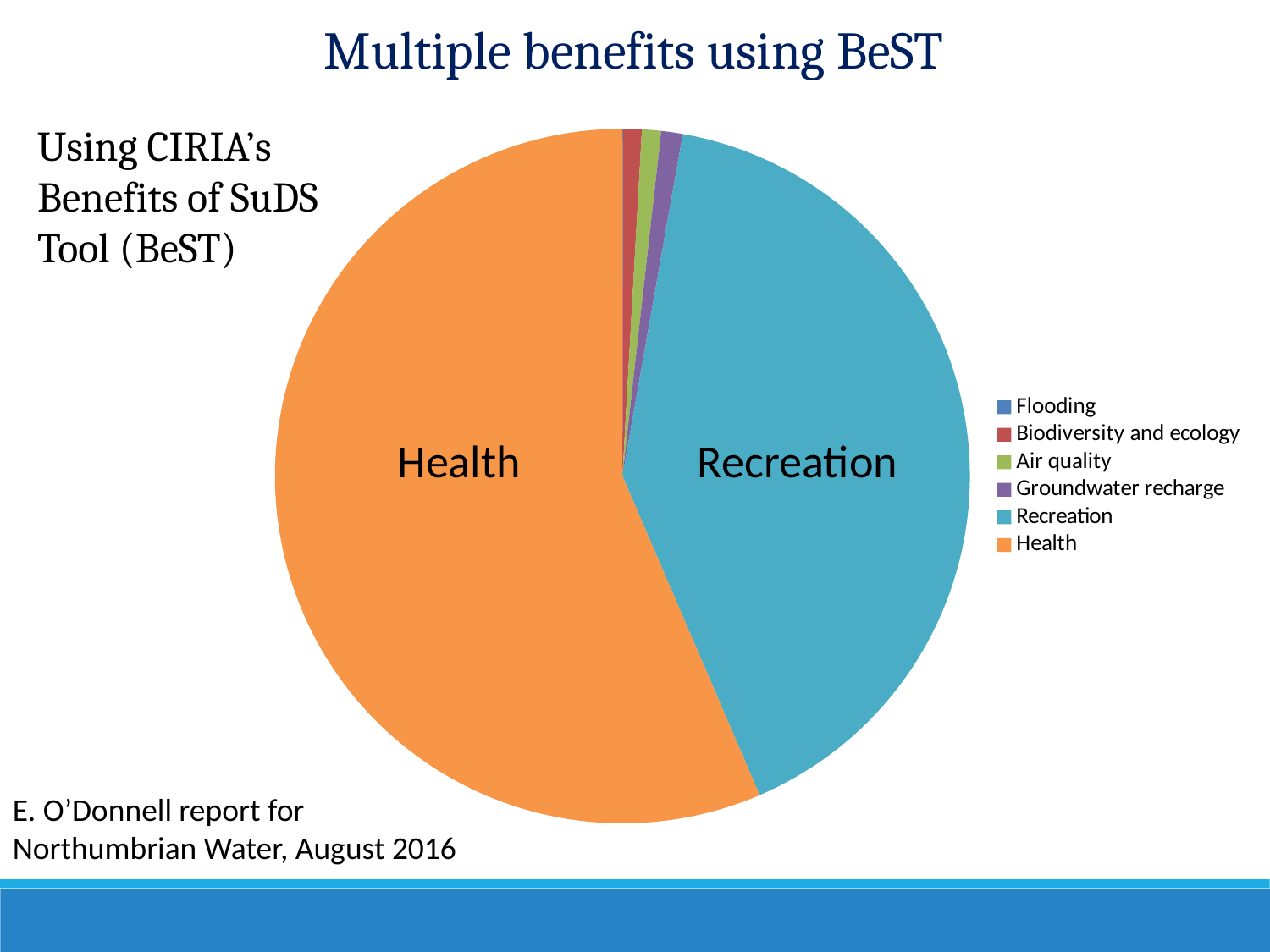
Which category has the largest slice of the pie chart? Health What kind of chart is shown on the slide? Pie chart Which category is the second-largest slice of the pie chart? Recreation Which slice is larger, Recreation or Biodiversity and ecology? Recreation What is the title of the slide containing the pie chart? Multiple benefits using BeST Which slice is larger, Recreation or Air quality? Recreation Which two categories are labelled directly on the pie slices? Health and Recreation Which slice is larger, Health or Groundwater recharge? Health How many categories does the legend of the pie chart list? 6